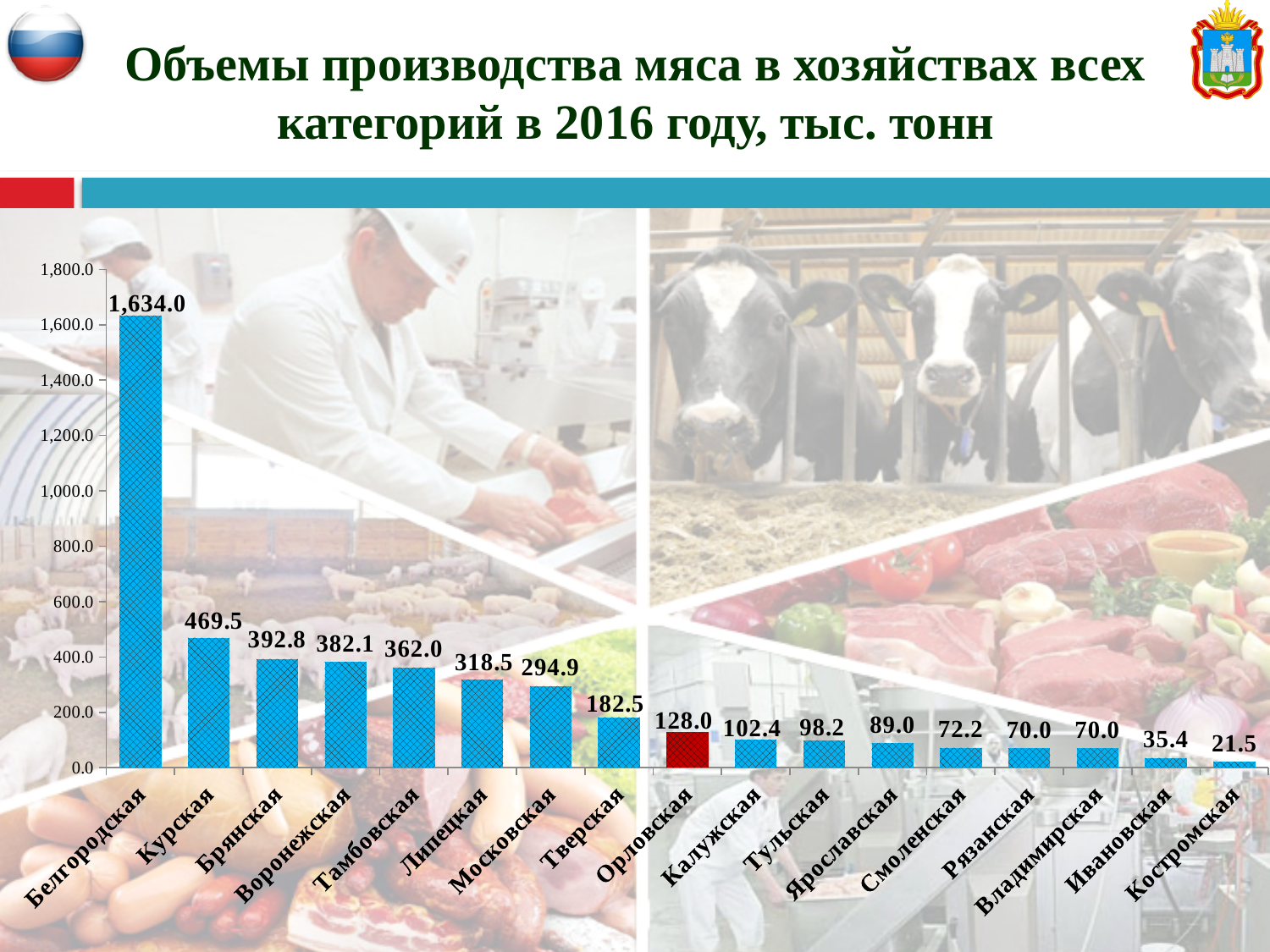
Which region has the lowest value? Костромская What is the value for Орловская? 128.0 What is the difference between the values for Белгородская and Курская? 1,164.5 What is the value for Тамбовская? 362.0 Which is larger, the value for Брянская or the value for Липецкая? Брянская Do the values rise or fall from left to right along the x axis? fall How many regions are shown on the chart? 17 What is the difference between the values for Орловская and Калужская? 25.6 Is the value for Курская greater or less than 400.0? greater What kind of chart is shown on the slide? bar chart What is the value for Белгородская? 1,634.0 Which region has the highest value? Белгородская